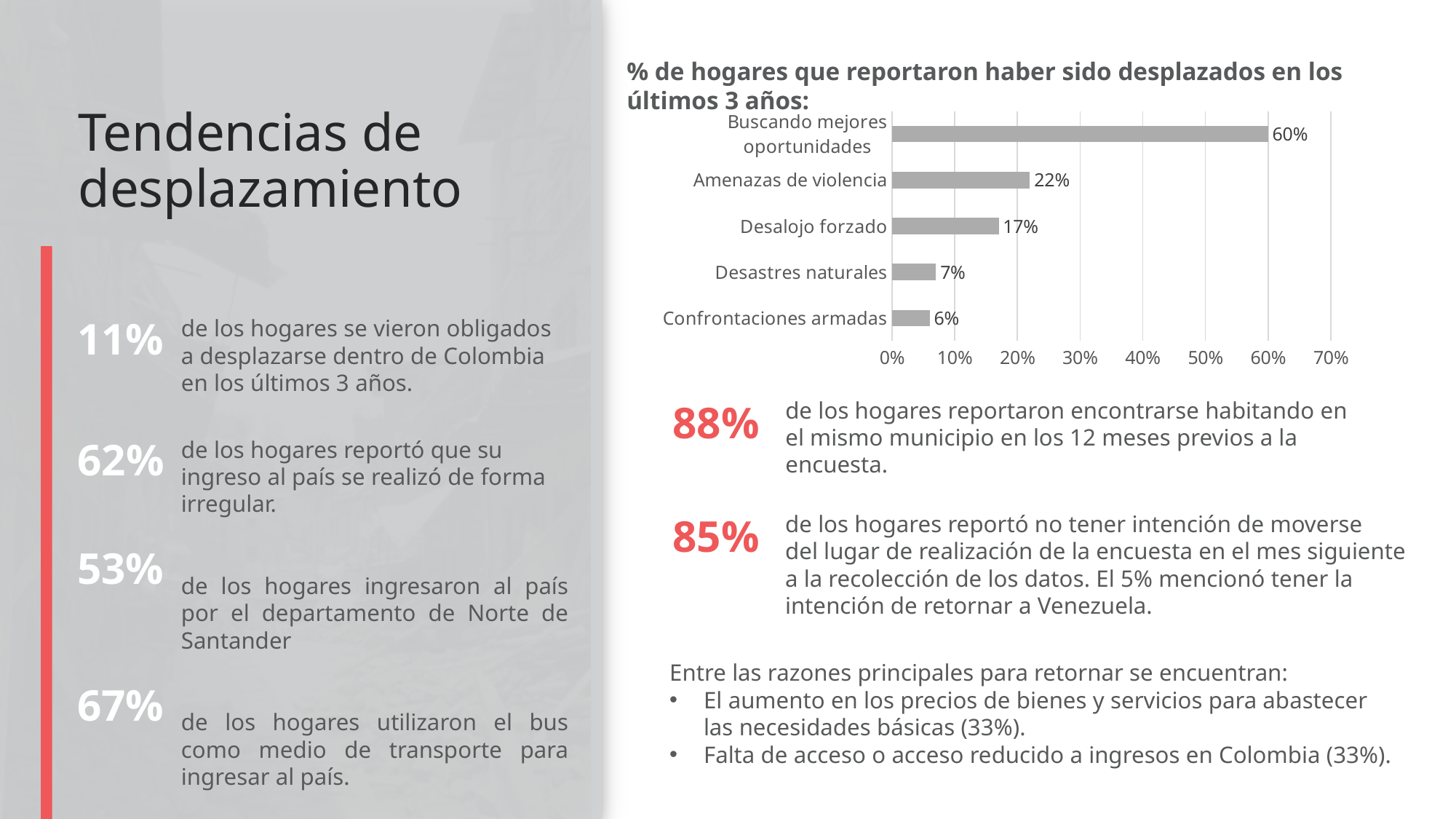
Which is larger, the value for "Amenazas de violencia" or the value for "Desalojo forzado"? Amenazas de violencia What is the value for "Confrontaciones armadas"? 6% Is the value for "Buscando mejores oportunidades" greater or less than 50%? greater What is the difference between the values for "Buscando mejores oportunidades" and "Amenazas de violencia"? 38% What is the difference between the values for "Desastres naturales" and "Confrontaciones armadas"? 1% What is the value for "Buscando mejores oportunidades"? 60% What is the value for "Desalojo forzado"? 17% How many categories are shown in the chart? 5 Which category has the lowest value? Confrontaciones armadas What is the value for "Amenazas de violencia"? 22% Which category has the highest value? Buscando mejores oportunidades What kind of chart is shown on the slide? Bar chart